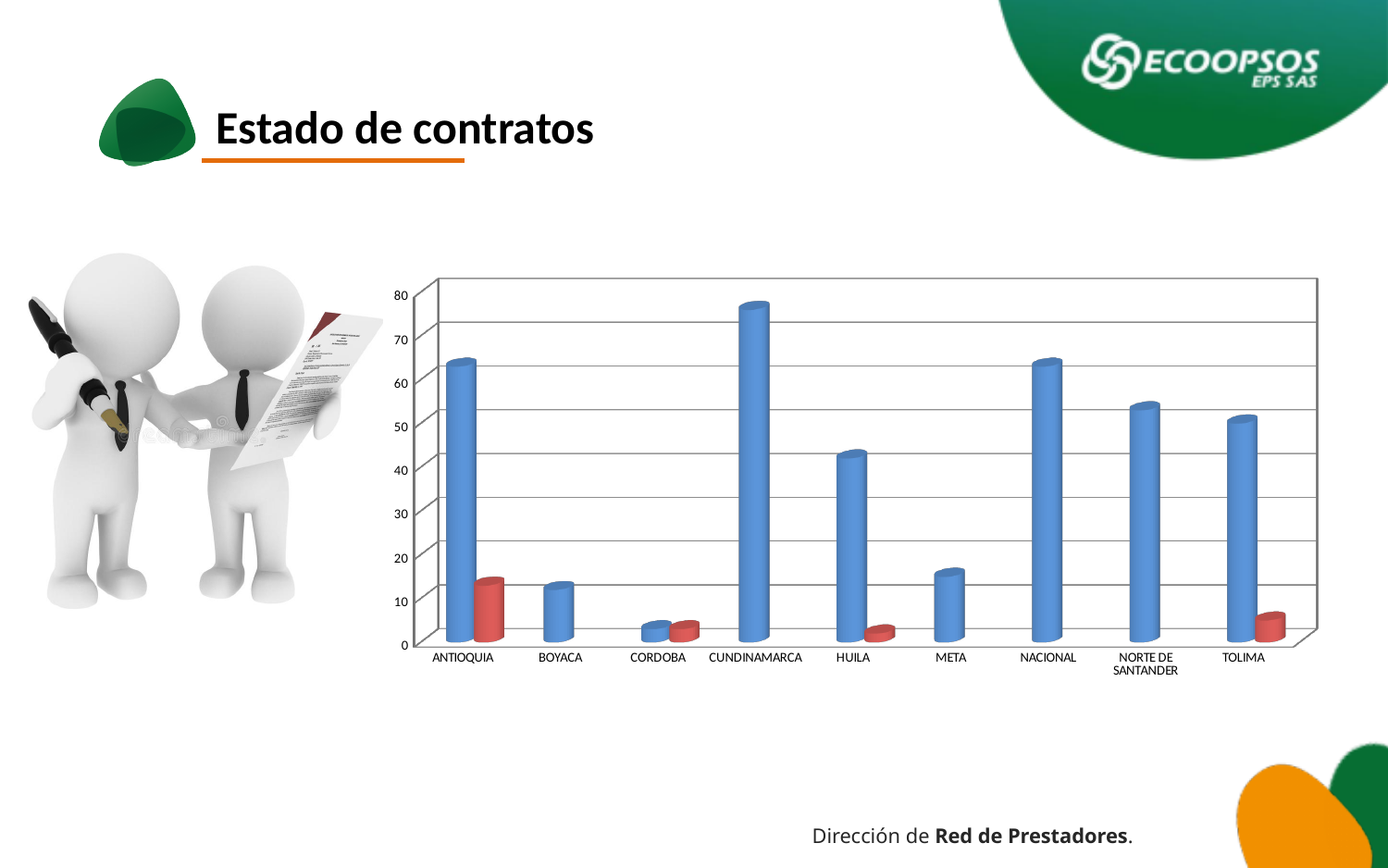
Which has a taller blue bar, CUNDINAMARCA or HUILA? CUNDINAMARCA Is the blue bar for BOYACA greater or less than 20? less Is the blue bar for META greater or less than 20? less Which category has the tallest blue bar? CUNDINAMARCA Is the blue bar for HUILA greater or less than 50? less Which category has the shortest blue bar? CORDOBA Which has a taller blue bar, ANTIOQUIA or BOYACA? ANTIOQUIA What kind of chart is shown on the slide? bar chart What two colours are used for the bars in the chart? blue and red How many categories are shown on the x axis of the chart? 9